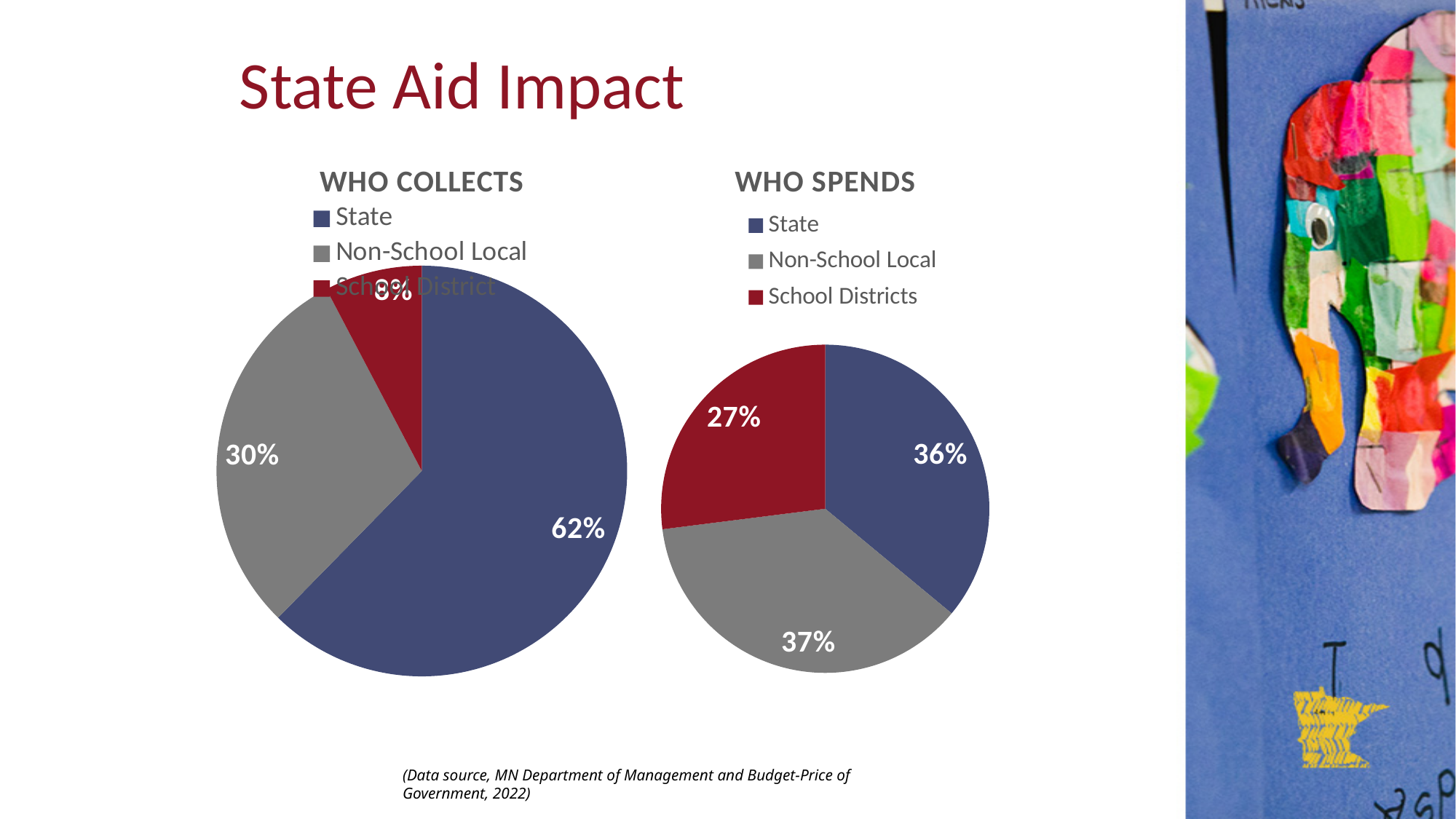
In the WHO COLLECTS chart, what share is labelled for Non-School Local? 30% In the WHO SPENDS chart, what share is labelled for School Districts? 27% What kind of chart is the WHO SPENDS chart? Pie chart How many categories does the legend of the WHO COLLECTS chart list? 3 In the WHO COLLECTS chart, what share is labelled for School District? 8% In the WHO COLLECTS chart, which category has the largest slice? State In the WHO SPENDS chart, which is larger: the State slice or the School Districts slice? State In the WHO SPENDS chart, what share is labelled for Non-School Local? 37% In the WHO SPENDS chart, which category has the smallest slice? School Districts In the WHO COLLECTS chart, what share is labelled for State? 62% In the WHO SPENDS chart, what share is labelled for State? 36% In the WHO COLLECTS chart, what is the difference between the State share and the Non-School Local share? 32%